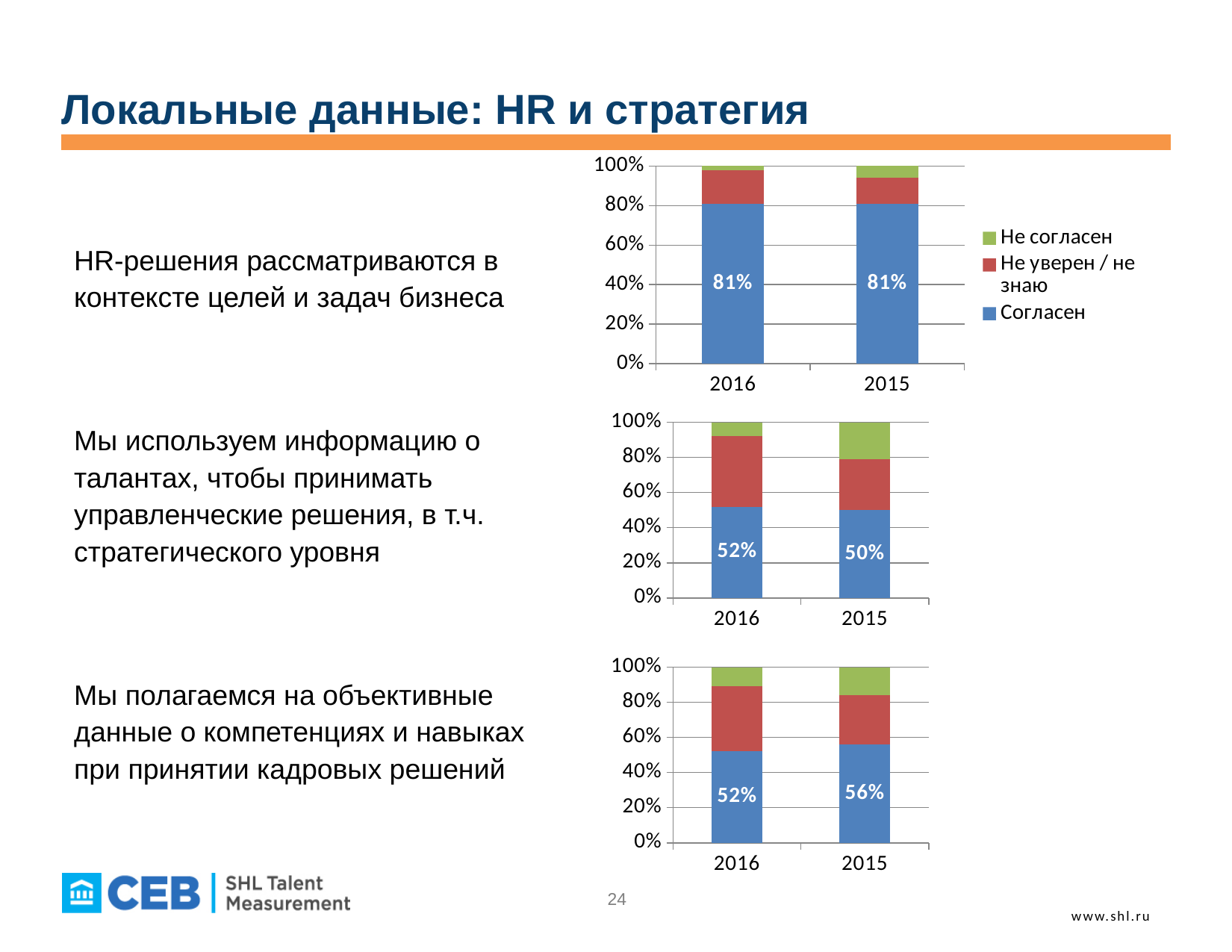
In the middle chart, what is the value for Согласен in 2015? 50% What colour represents the Согласен series in the charts? Blue In the bottom chart, what is the value for Согласен in 2015? 56% How many categories are shown on the x axis of the middle chart? 2 How many series does the legend on the slide list? 3 In the middle chart, what is the difference between the Согласен values for 2016 and 2015? 2% What kind of chart is the top chart? Stacked bar chart In the bottom chart, which year has the larger Согласен value, 2016 or 2015? 2015 In the top chart, what is the value for Согласен in 2016? 81% In the top chart, is the Не согласен share for 2015 greater or less than 20%? less In the bottom chart, what is the value for Согласен in 2016? 52% In the bottom chart, what is the difference between the Согласен values for 2015 and 2016? 4%